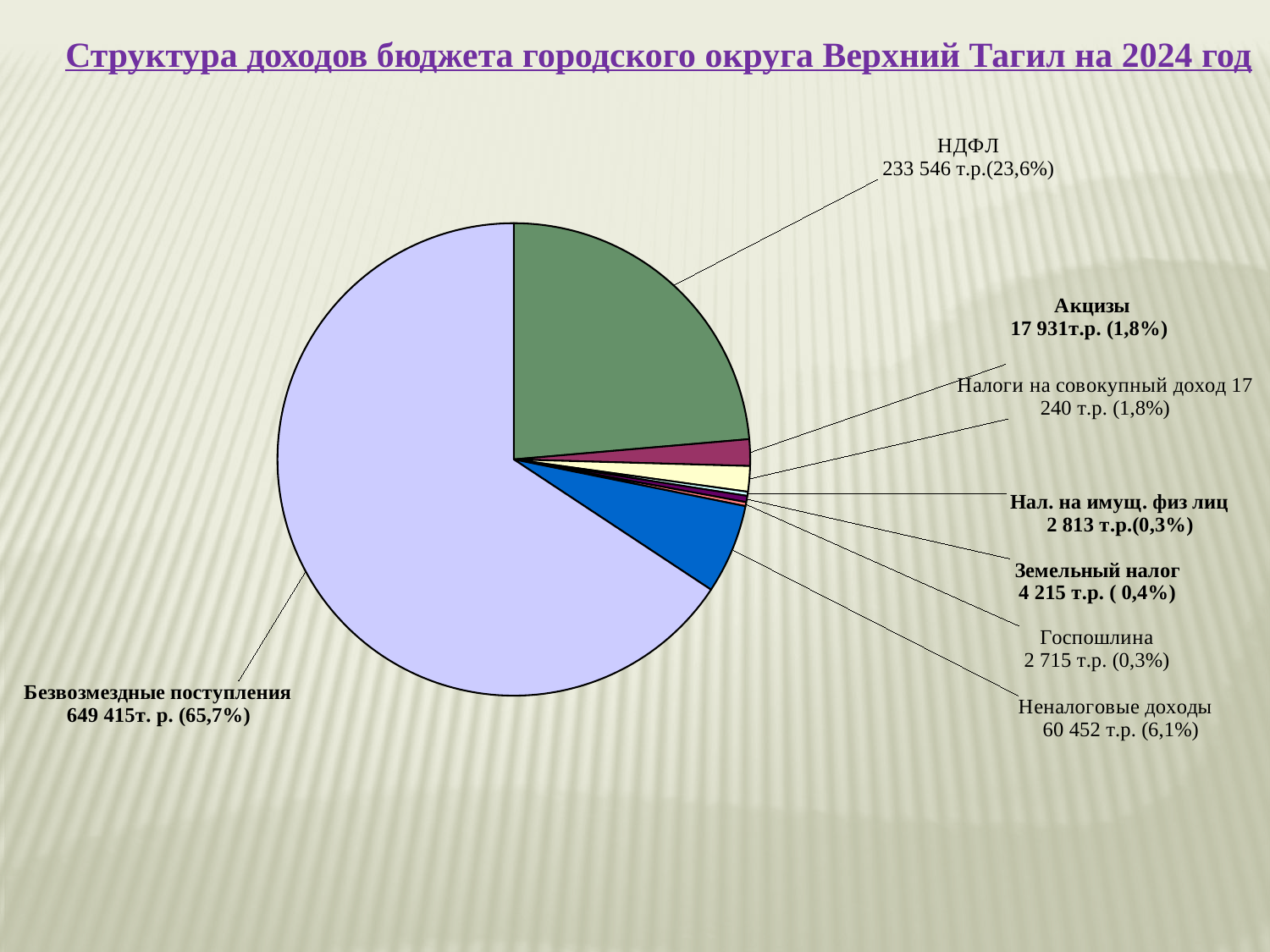
What share of the pie does Неналоговые доходы represent? 6,1% What is the value shown for НДФЛ? 233 546 т.р. How many slices does the pie chart have? 8 Which category has the smallest value in the pie chart? Госпошлина What is the title of the chart on the slide? Структура доходов бюджета городского округа Верхний Тагил на 2024 год What share of the pie does Безвозмездные поступления represent? 65,7% What is the difference in value between Безвозмездные поступления and НДФЛ? 415 869 т.р. What kind of chart is shown on the slide? pie chart What is the difference in percentage share between Безвозмездные поступления and НДФЛ? 42,1% Which category has the largest slice of the pie? Безвозмездные поступления What is the value shown for Земельный налог? 4 215 т.р. Which is larger, Акцизы or Неналоговые доходы? Неналоговые доходы